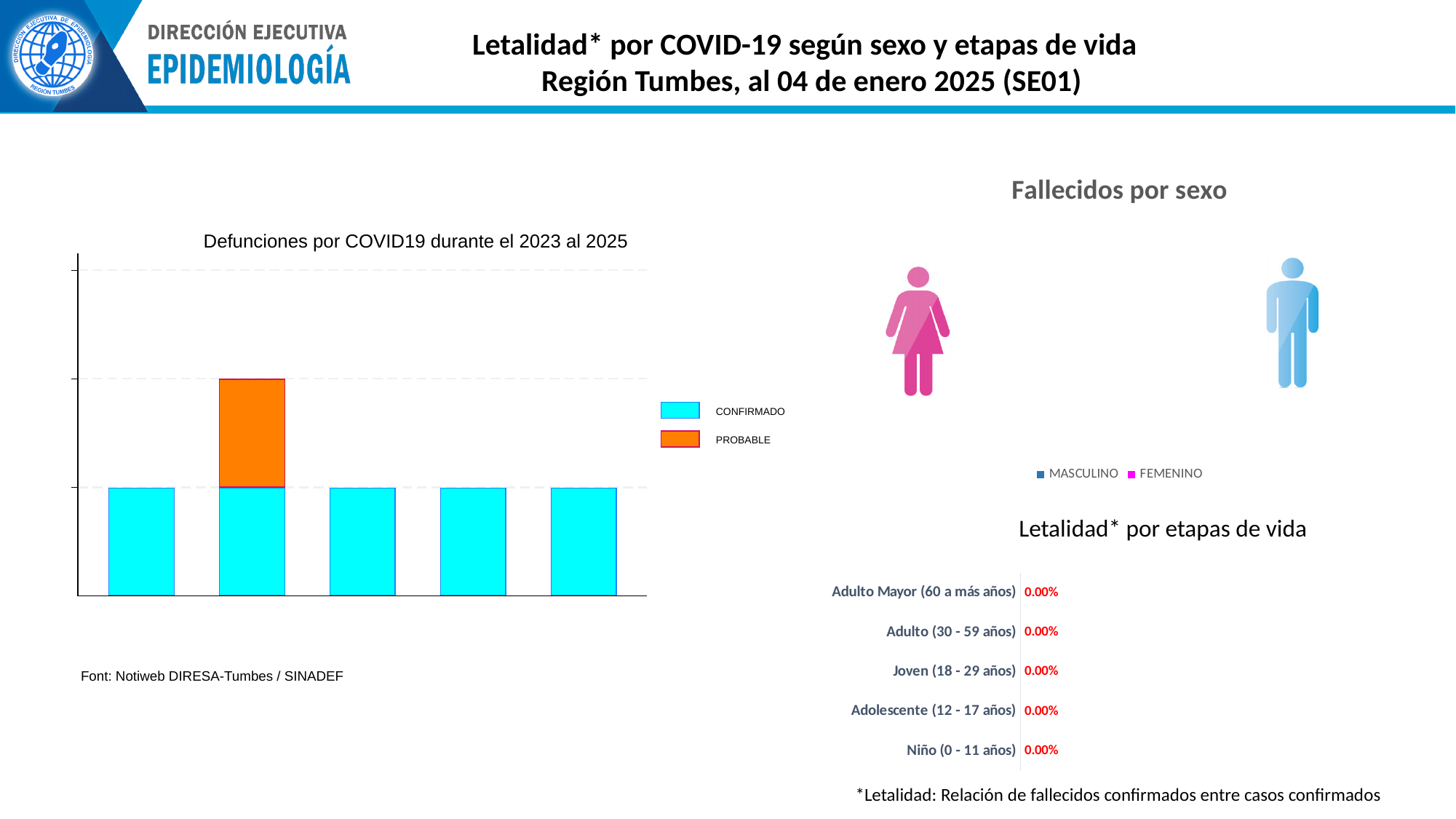
In the 'Defunciones por COVID19 durante el 2023 al 2025' chart, which series is shown in orange? PROBABLE What kind of chart is 'Defunciones por COVID19 durante el 2023 al 2025'? Stacked bar chart How many bars are plotted in the 'Defunciones por COVID19 durante el 2023 al 2025' chart? 5 How many series does the legend of the 'Defunciones por COVID19 durante el 2023 al 2025' chart list? 2 How many age-group categories are shown in the 'Letalidad* por etapas de vida' chart? 5 In the 'Letalidad* por etapas de vida' chart, what is the value for Adolescente (12 - 17 años)? 0.00% What are the two legend entries of the 'Fallecidos por sexo' chart? MASCULINO and FEMENINO In the 'Letalidad* por etapas de vida' chart, what is the value for Joven (18 - 29 años)? 0.00% How many series does the legend of the 'Fallecidos por sexo' chart list? 2 In the 'Letalidad* por etapas de vida' chart, what is the value for Niño (0 - 11 años)? 0.00% In the 'Letalidad* por etapas de vida' chart, what is the value for Adulto Mayor (60 a más años)? 0.00% In the 'Letalidad* por etapas de vida' chart, what is the difference between the values for Adulto (30 - 59 años) and Niño (0 - 11 años)? 0.00%